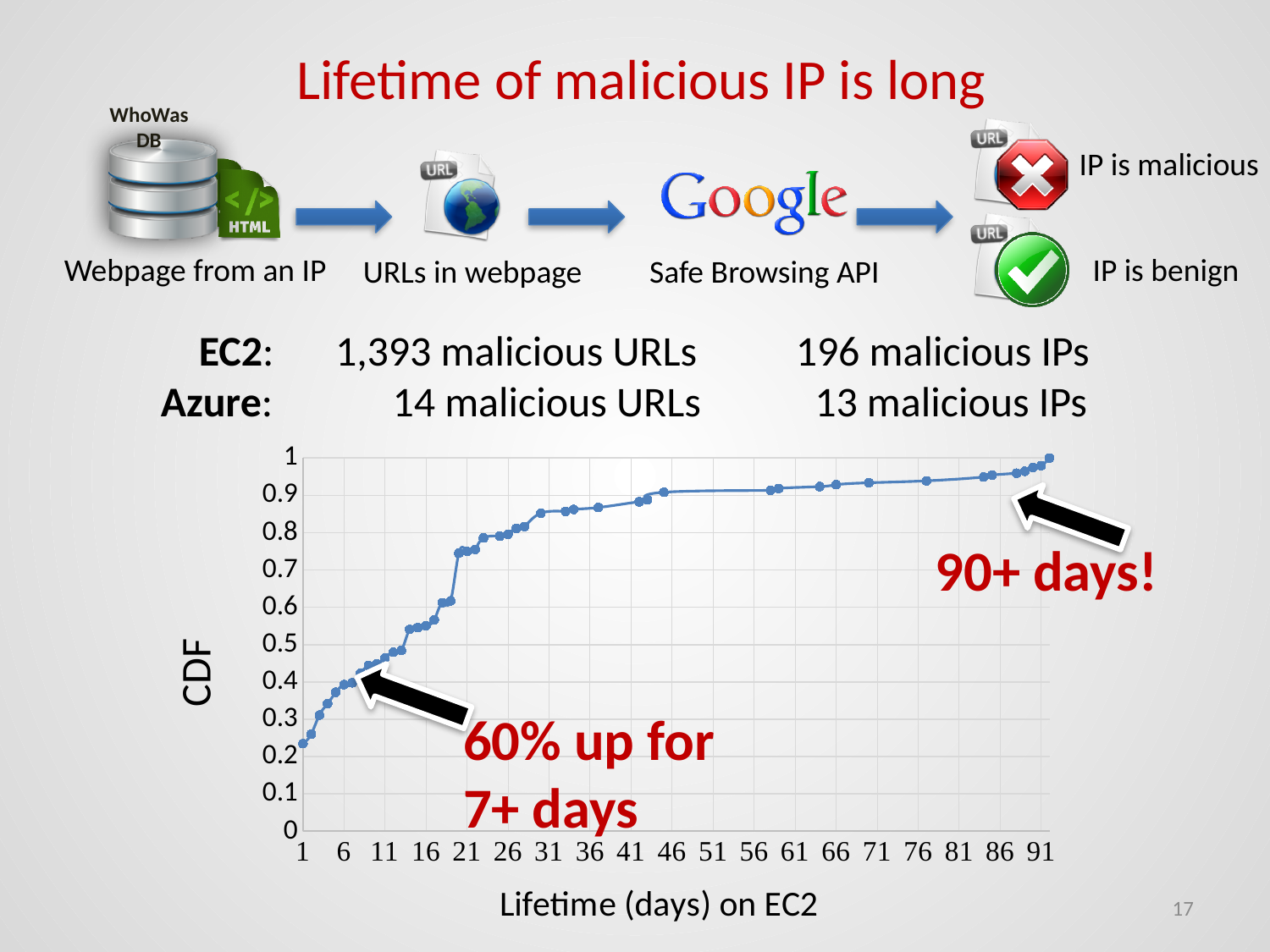
What is the title of the x axis of the chart? Lifetime (days) on EC2 Is the CDF value at a lifetime of 1 day greater or less than 0.3? less Is the CDF value at a lifetime of 31 days greater or less than 0.8? greater What kind of chart is shown on the slide? line chart What annotation text is placed near the right end of the curve? 90+ days! Is the CDF value at 21 days larger or smaller than the CDF value at 11 days? larger Is the CDF value at a lifetime of 46 days greater or less than 0.8? greater Which lifetime value on the x axis has the lowest CDF value? 1 Do the CDF values rise or fall as the lifetime in days increases along the x axis? rise